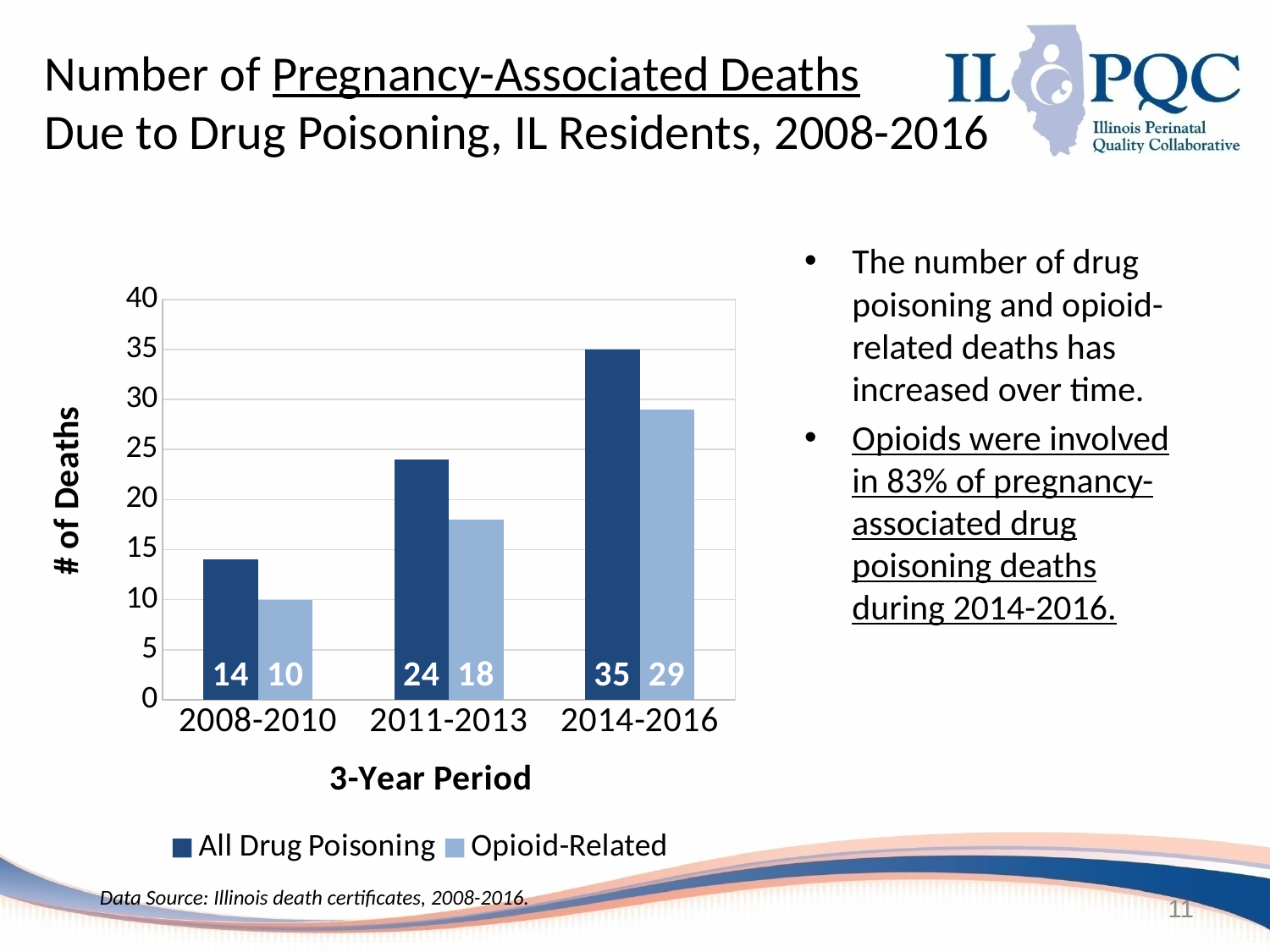
Which 3-year period has the lowest number of Opioid-Related deaths? 2008-2010 What kind of chart is shown on the slide? Bar chart Do the All Drug Poisoning deaths rise or fall across the 3-year periods? Rise What is the number of Opioid-Related deaths for 2014-2016? 29 What is the difference in All Drug Poisoning deaths between 2011-2013 and 2008-2010? 10 Which 3-year period has the highest number of All Drug Poisoning deaths? 2014-2016 What is the number of Opioid-Related deaths for 2011-2013? 18 How many 3-year periods are shown on the x axis? 3 What is the difference between All Drug Poisoning and Opioid-Related deaths in 2014-2016? 6 Which is larger: Opioid-Related deaths in 2011-2013 or All Drug Poisoning deaths in 2008-2010? Opioid-Related deaths in 2011-2013 How many series does the legend list? 2 What is the number of All Drug Poisoning deaths for 2008-2010? 14